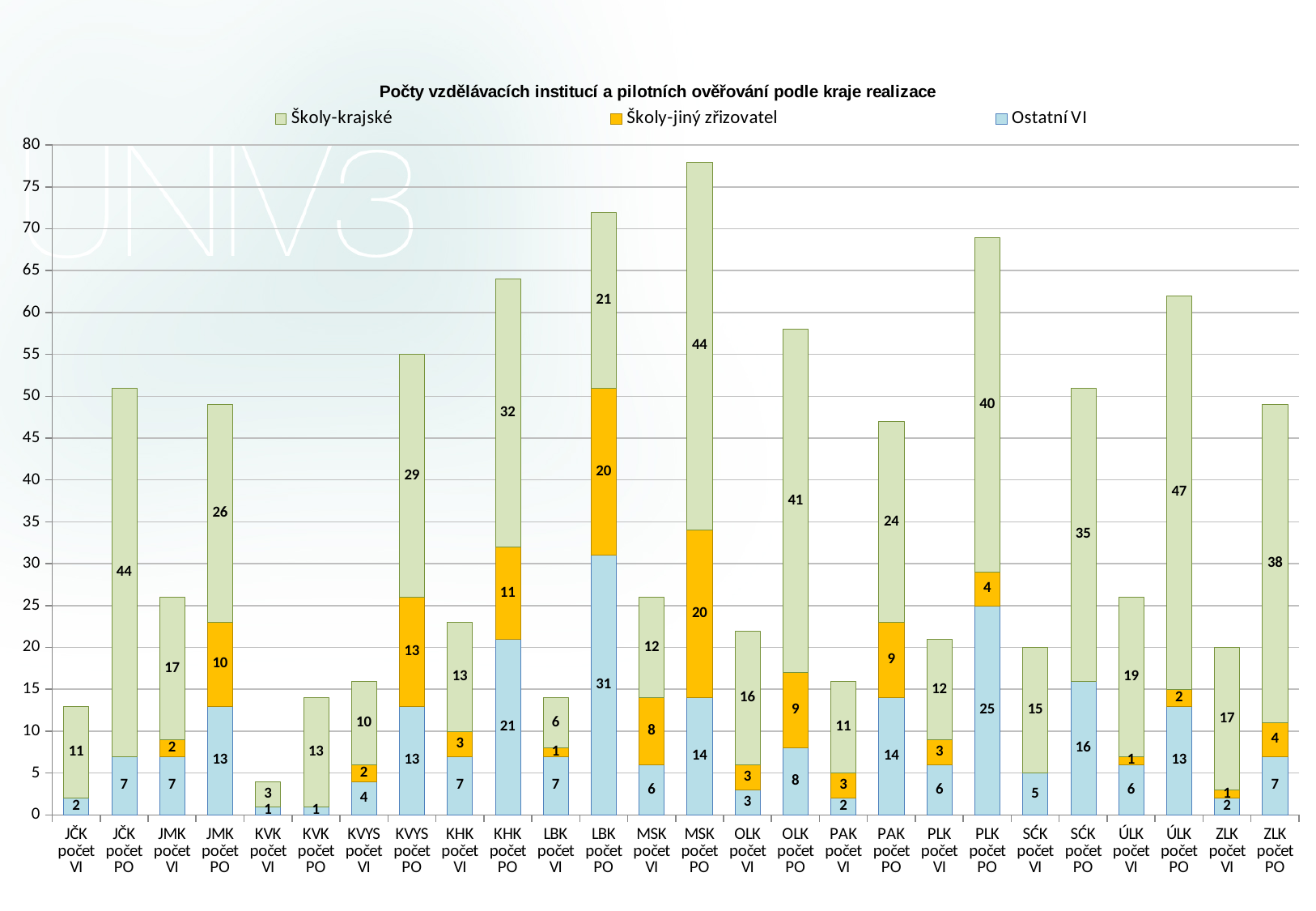
What is the title of the chart? Počty vzdělávacích institucí a pilotních ověřování podle kraje realizace What is the value of Školy-krajské for JČK počet PO? 44 Which is larger: the Ostatní VI value for LBK počet PO or for KHK počet PO? LBK počet PO What kind of chart is shown on the slide? stacked bar chart What is the value of Ostatní VI for PLK počet PO? 25 How many series does the legend list? 3 What is the total of the stacked bar for MSK počet PO? 78 What is the value of Školy-jiný zřizovatel for LBK počet PO? 20 What is the total of the stacked bar for KHK počet PO? 64 Which category has the tallest stacked bar overall? MSK počet PO Which category has the shortest stacked bar overall? KVK počet VI What is the difference between the Školy-krajské values for ÚLK počet PO and ÚLK počet VI? 28